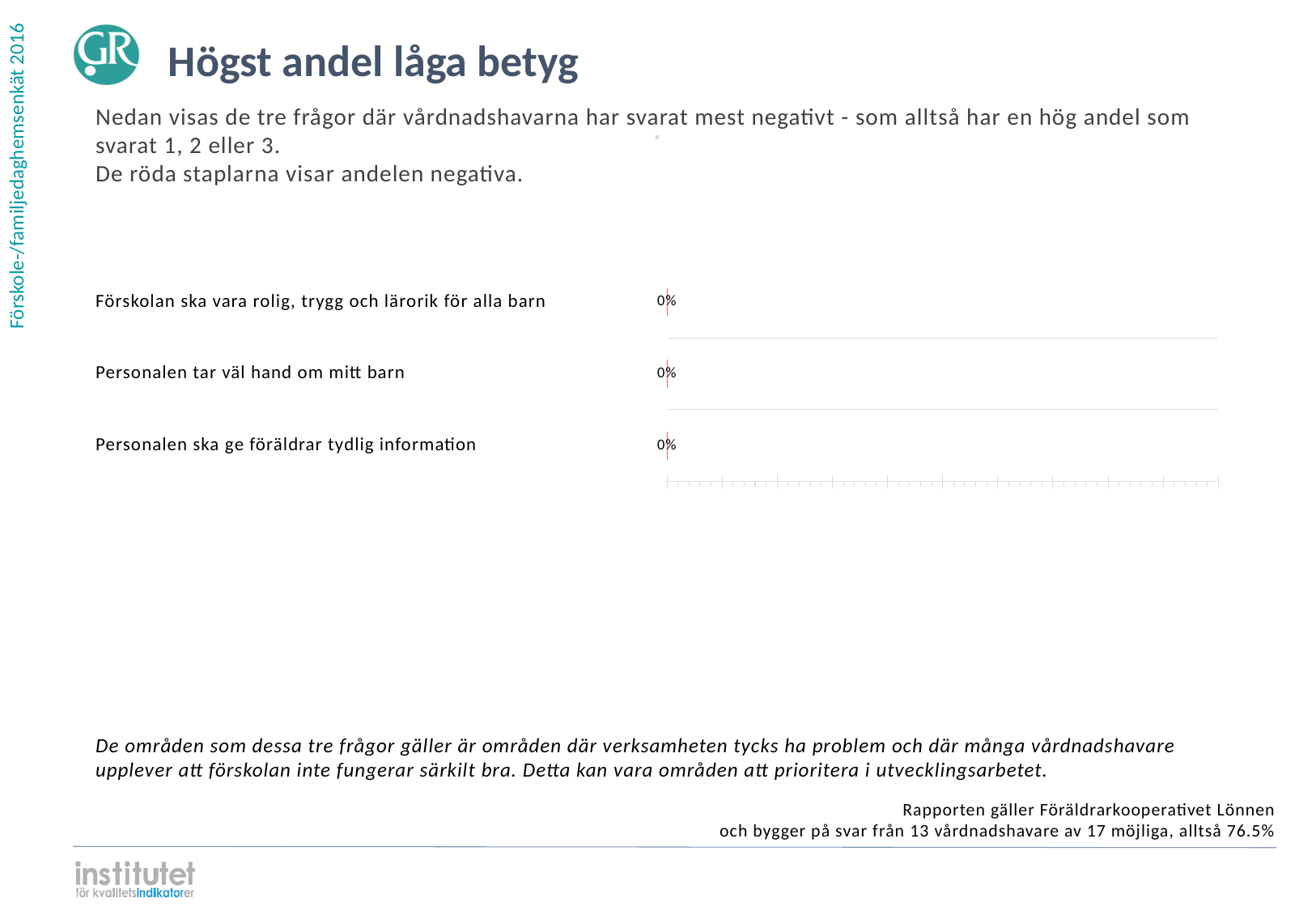
What is the value shown for "Personalen ska ge föräldrar tydlig information"? 0% Which category is listed first (at the top) in the chart? Förskolan ska vara rolig, trygg och lärorik för alla barn What is the difference between the values for "Personalen tar väl hand om mitt barn" and "Personalen ska ge föräldrar tydlig information"? 0% What kind of chart is shown on the slide? Bar chart What is the title of the slide containing the chart? Högst andel låga betyg What is the value shown for "Personalen tar väl hand om mitt barn"? 0% According to the slide text, what do the red bars show? Andelen negativa Is the value for "Förskolan ska vara rolig, trygg och lärorik för alla barn" greater or less than 50%? less What is the value shown for "Förskolan ska vara rolig, trygg och lärorik för alla barn"? 0% How many categories (questions) are shown in the chart? 3